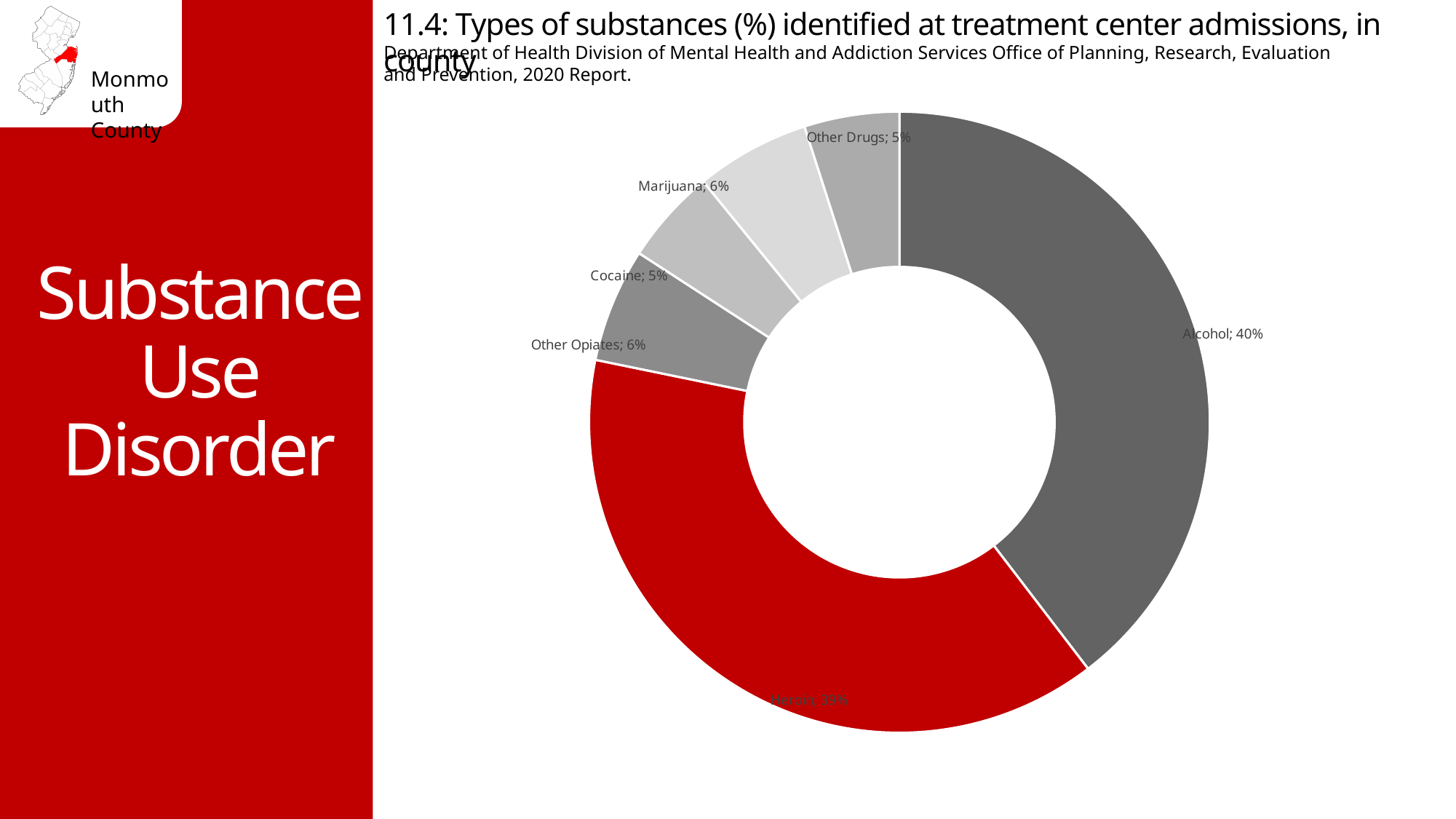
What percentage of treatment center admissions is attributed to Alcohol? 40% What percentage is shown for Heroin? 39% What percentage is shown for Cocaine? 5% Which slice of the chart is coloured red? Heroin What is the difference between the Alcohol share and the Other Opiates share? 34 percentage points What percentage is shown for Other Opiates? 6% What percentage is shown for Marijuana? 6% What type of chart is shown on the slide? Doughnut (pie) chart Which substance has the largest share of admissions? Alcohol Which is larger, the share for Marijuana or the share for Alcohol? Alcohol What percentage is shown for Other Drugs? 5% How many substance categories are shown in the chart? 6